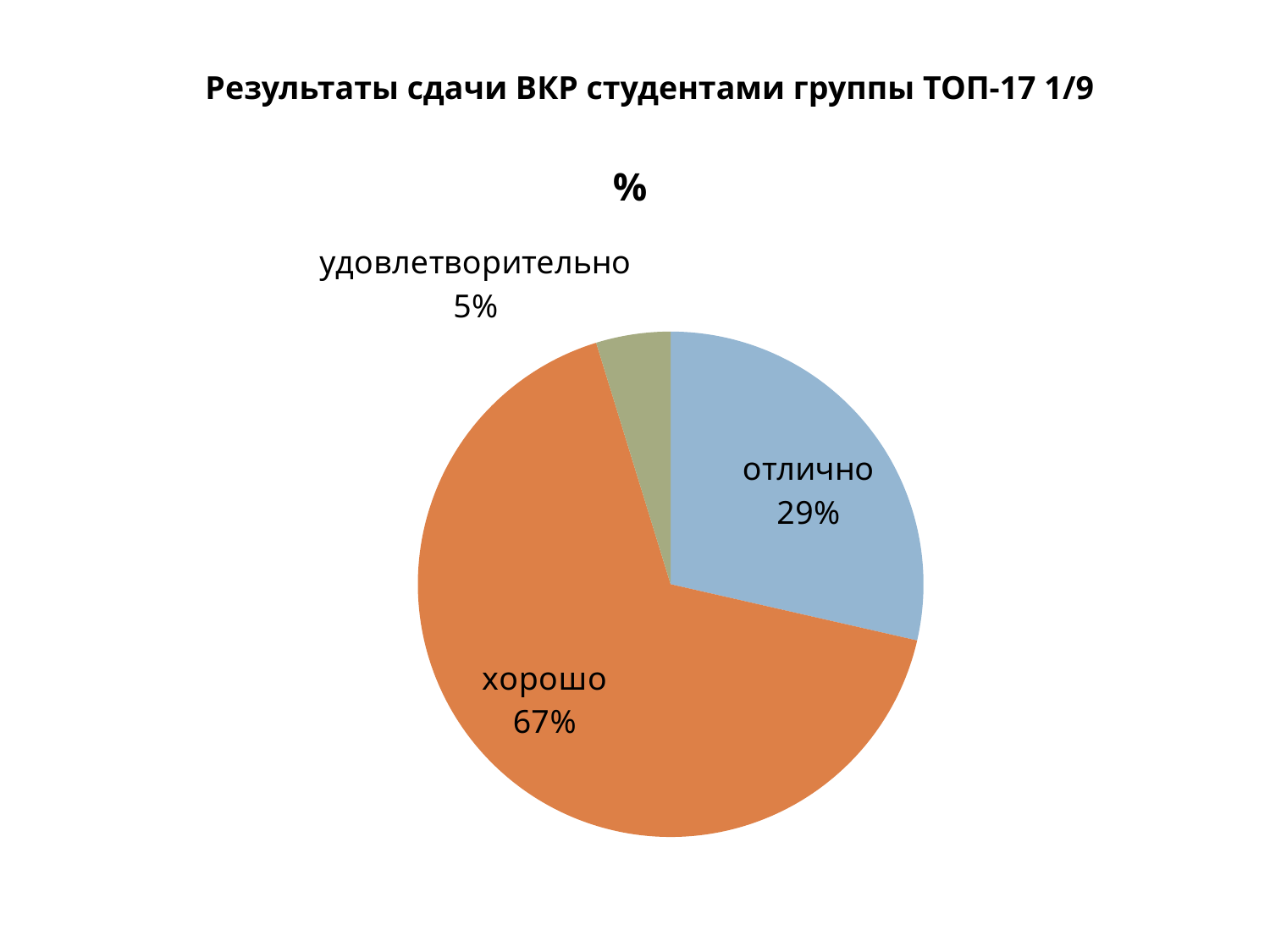
What share of the pie does the "удовлетворительно" slice represent? 5% Which category has the smallest slice of the pie? удовлетворительно What is the title of the chart? % What colour is the "хорошо" slice? orange What share of the pie does the "отлично" slice represent? 29% How many slices does the pie chart have? 3 Which category has the largest slice of the pie? хорошо What is the difference in percentage points between the "отлично" and "удовлетворительно" slices? 24 What is the difference in percentage points between the "хорошо" and "отлично" slices? 38 What share of the pie does the "хорошо" slice represent? 67% Which slice is larger, "отлично" or "удовлетворительно"? отлично What kind of chart is shown on the slide? pie chart